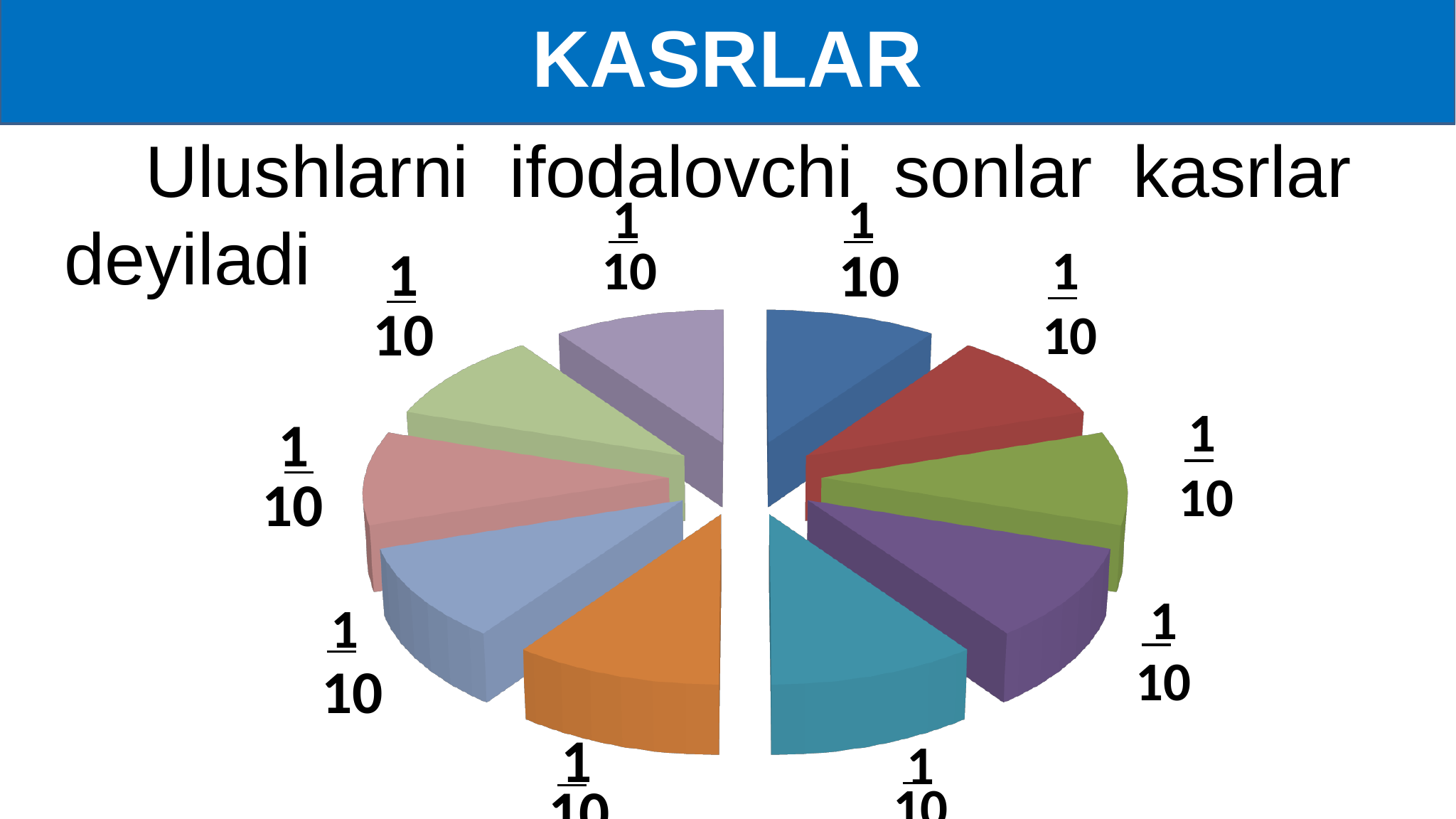
How many slices does the pie chart have? 10 What is the total of all the slice labels in the pie chart? 10/10 What kind of chart is shown on the slide? pie chart What is the title shown in the blue banner at the top of the slide? KASRLAR Are the slices of the pie chart all the same size or different sizes? the same size What share of the pie does the orange slice represent? 1/10 What value is printed as the label on each slice of the pie chart? 1/10 What share of the pie does the teal slice at the bottom right represent? 1/10 Is the pie chart drawn in 3D with the slices pulled apart (exploded), or as a flat, unexploded pie? 3D exploded What share of the pie does the dark blue slice at the top represent? 1/10